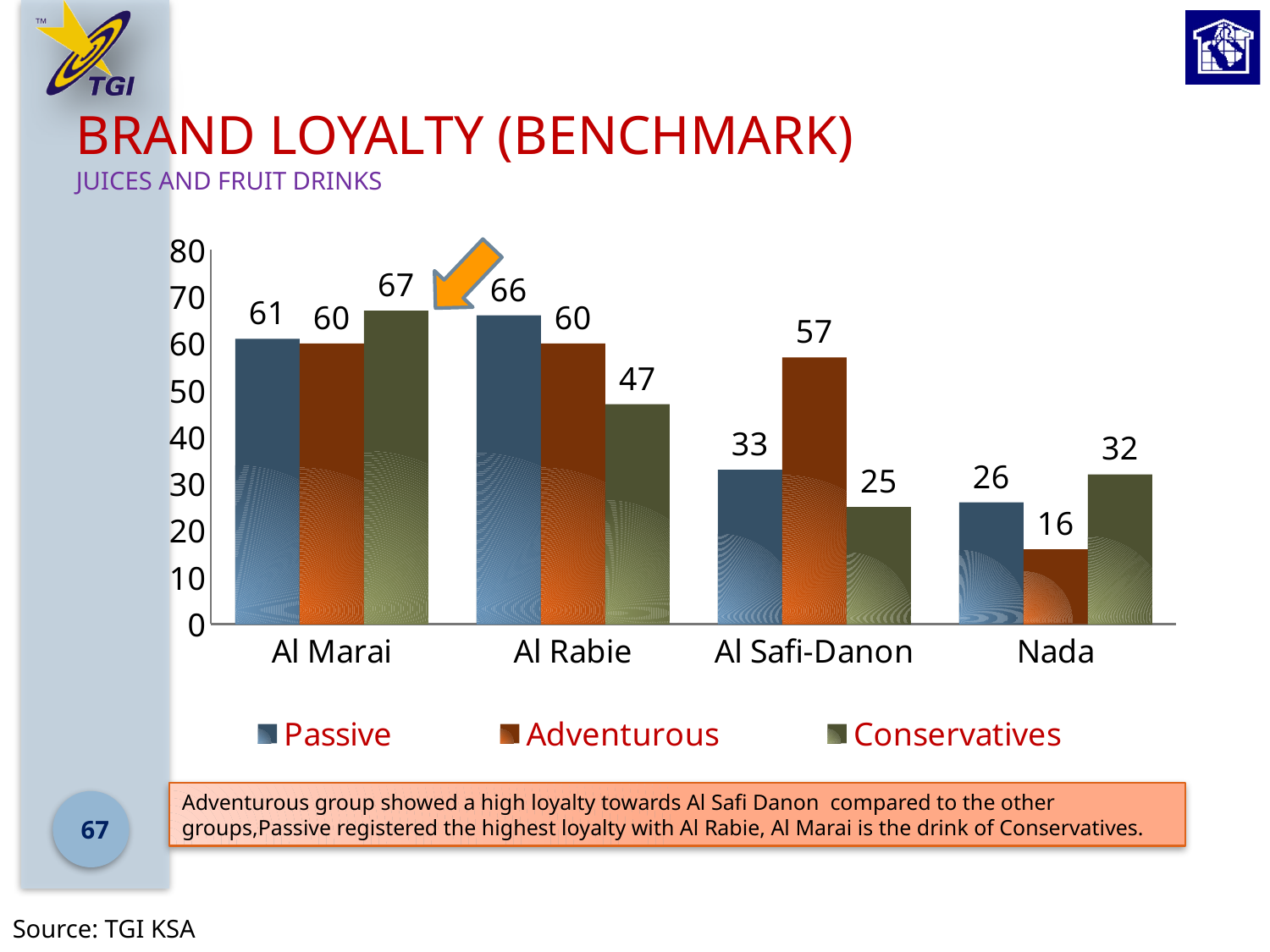
Which brand has the lowest Passive value? Nada What is the Adventurous value for Al Safi-Danon? 57 What is the Adventurous value for Nada? 16 How many series does the legend list? 3 What kind of chart is shown on the slide? Bar chart How many brands are shown on the x axis? 4 What is the Conservatives value for Al Rabie? 47 What are the three series listed in the legend? Passive, Adventurous, Conservatives Which is larger for Al Rabie: the Passive value or the Conservatives value? Passive Which brand has the highest Conservatives value? Al Marai What is the Passive value for Al Marai? 61 What is the difference between the Adventurous and Conservatives values for Al Safi-Danon? 32